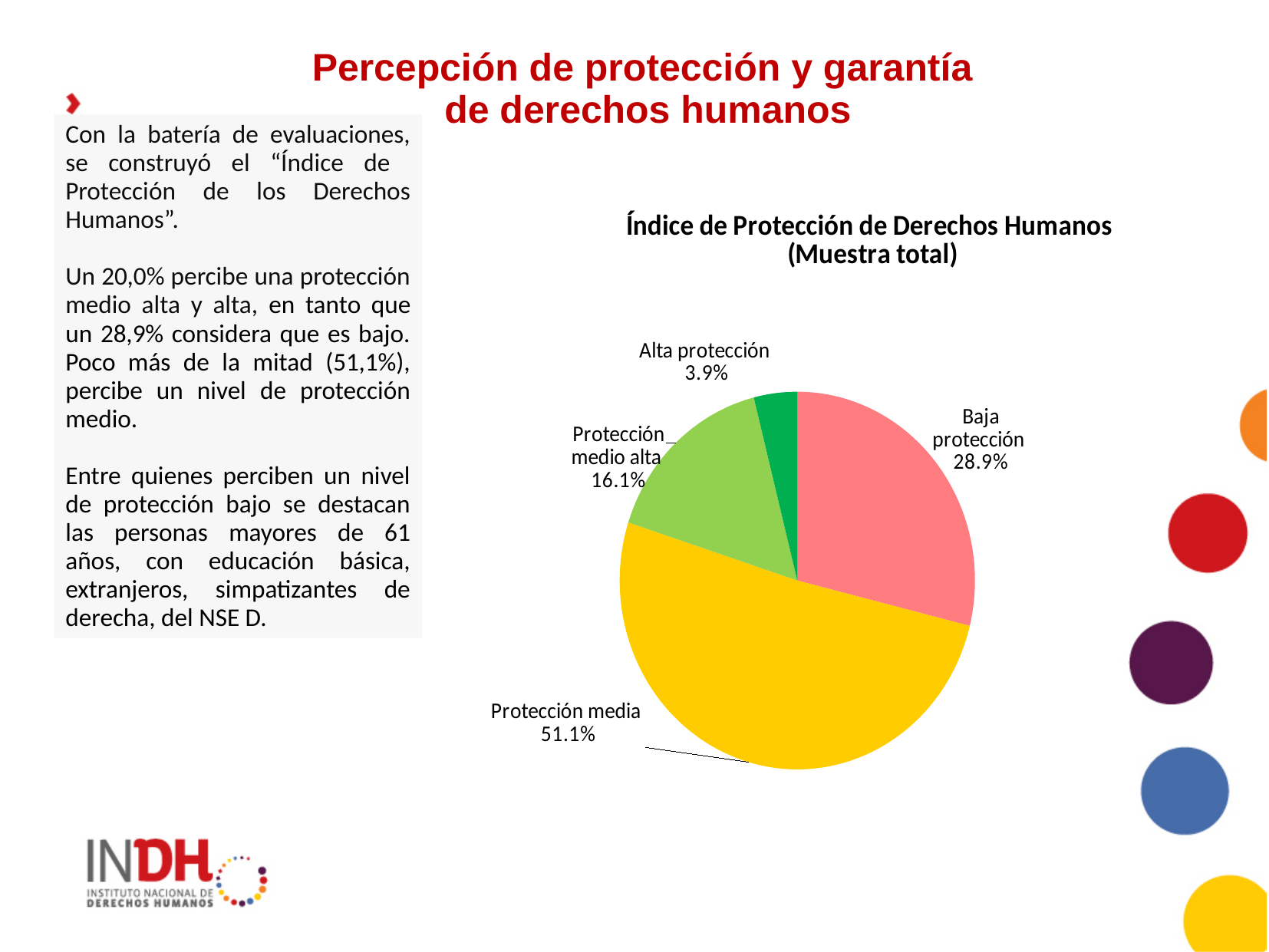
What is the title of the chart? Índice de Protección de Derechos Humanos (Muestra total) What is the difference in percentage points between Baja protección and Protección medio alta? 12.8 What percentage of the pie corresponds to Alta protección? 3.9% What type of chart is shown on the slide? Pie chart What colour is the slice for Protección media? Yellow Which is larger, the slice for Baja protección or the slice for Protección medio alta? Baja protección Which category has the smallest slice of the pie? Alta protección Which category has the largest slice of the pie? Protección media What percentage of the pie corresponds to Baja protección? 28.9% How many categories are shown in the pie chart? 4 What percentage of the pie corresponds to Protección media? 51.1% What percentage of the pie corresponds to Protección medio alta? 16.1%